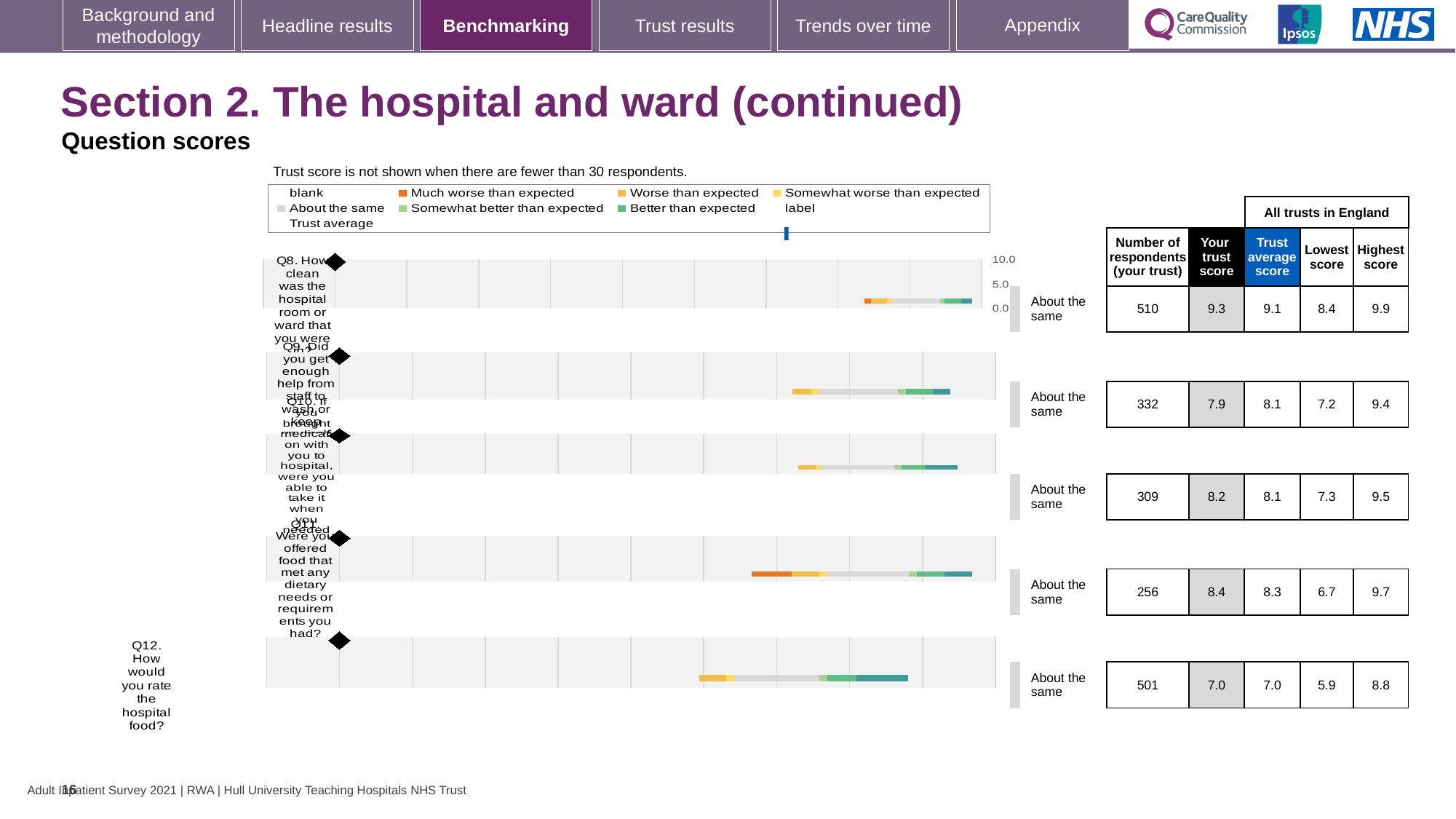
What is the number of respondents for Q12 (How would you rate the hospital food)? 501 What benchmark category is shown for all five questions on this slide? About the same Which question has the lowest 'Your trust score'? Q12 For Q9, which is larger: the 'Your trust score' or the trust average score? Trust average score What is the 'Your trust score' for Q8 (How clean was the hospital room or ward)? 9.3 Which question has the highest 'Your trust score'? Q8 How many questions (Q8 to Q12) are plotted in the chart? 5 What is the lowest score across all trusts in England for Q12? 5.9 What type of chart is used to show the question scores on this slide? bar chart What is the trust average score for Q11 (Were you offered food that met any dietary needs)? 8.3 What is the highest score across all trusts in England for Q10? 9.5 What is the difference between the trust score and the trust average score for Q8? 0.2